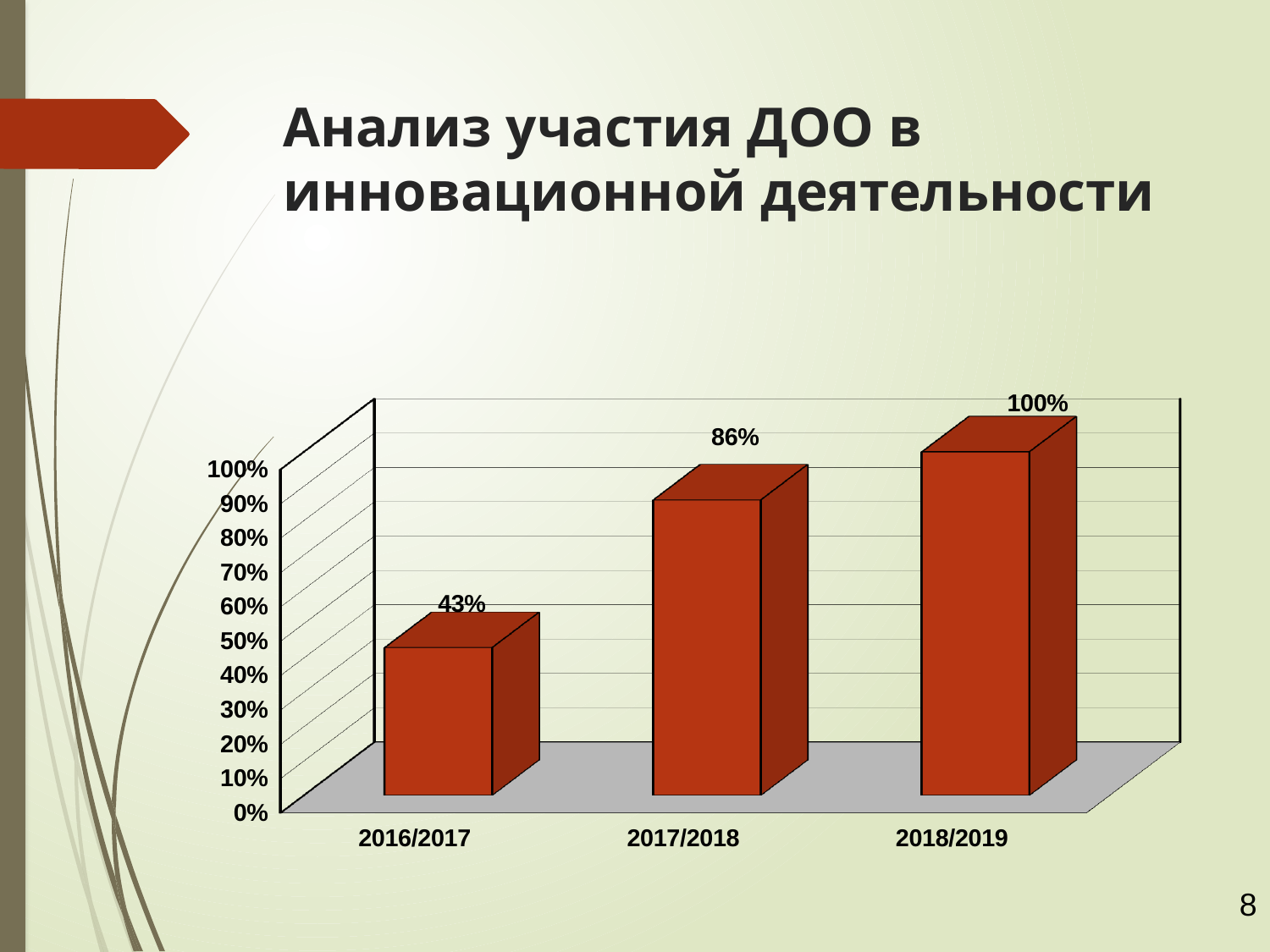
What is the value for 2018/2019? 100% Which category has the highest value? 2018/2019 Which is larger, the value for 2016/2017 or the value for 2017/2018? 2017/2018 Do the values rise or fall from 2016/2017 to 2018/2019? rise What is the title of the slide? Анализ участия ДОО в инновационной деятельности What is the value for 2017/2018? 86% Which category has the lowest value? 2016/2017 How many categories are shown on the x axis? 3 What is the value for 2016/2017? 43% What kind of chart is shown on the slide? bar chart What is the difference between the values for 2018/2019 and 2017/2018? 14% What is the difference between the values for 2017/2018 and 2016/2017? 43%